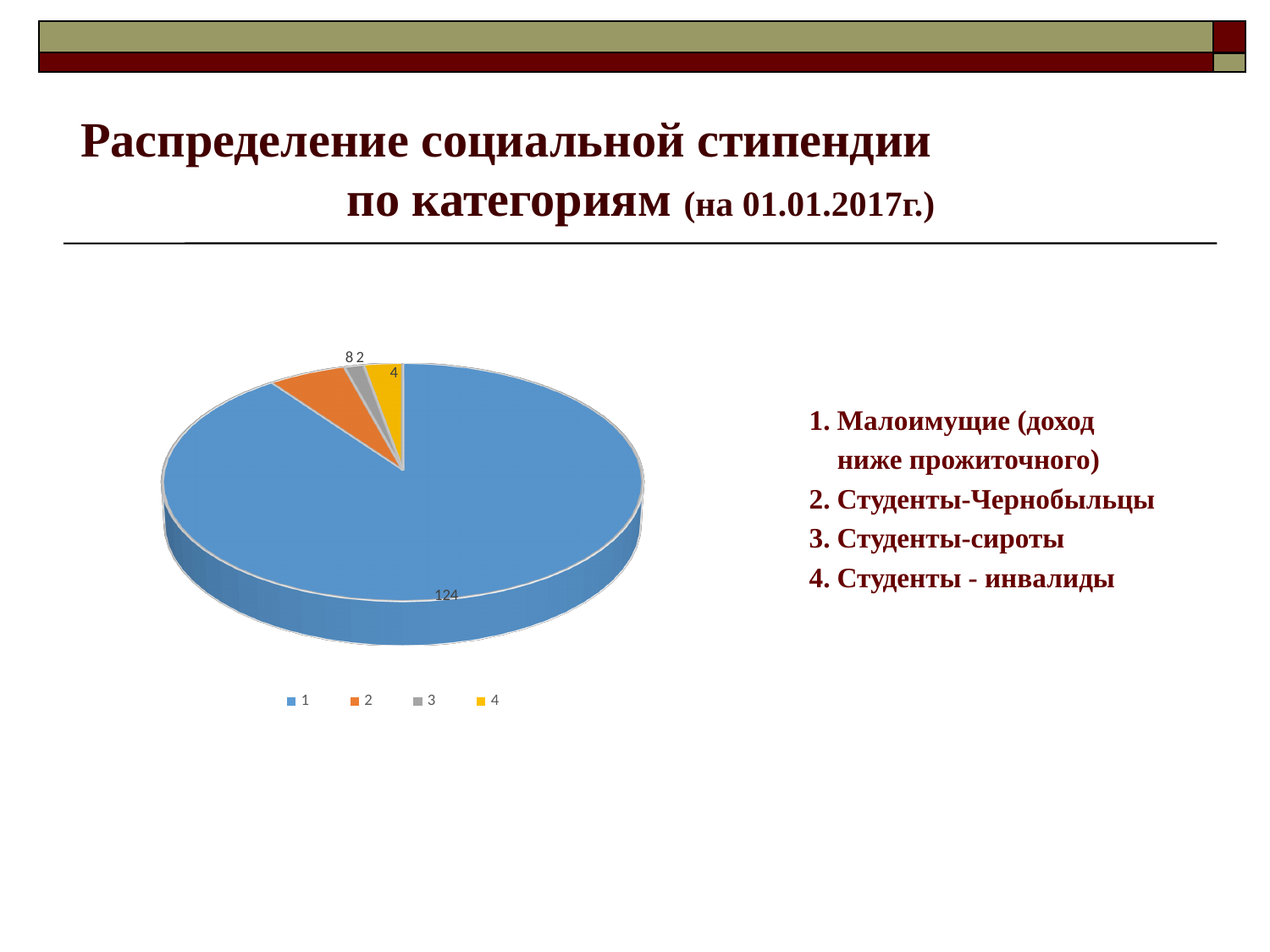
What is the difference between the values for category 1 and category 2? 116 What value is shown for category 4 in the pie chart? 4 How many entries does the legend list? 4 How many slices does the pie chart have? 4 What is the total of all the values shown in the pie chart? 138 What value is shown for category 1 in the pie chart? 124 Which category has the smallest slice in the pie chart? 3 What value is shown for category 3 in the pie chart? 2 What kind of chart is shown on the slide? pie chart Which is larger, the value for category 2 or the value for category 4? 2 What value is shown for category 2 in the pie chart? 8 Which category has the largest slice in the pie chart? 1